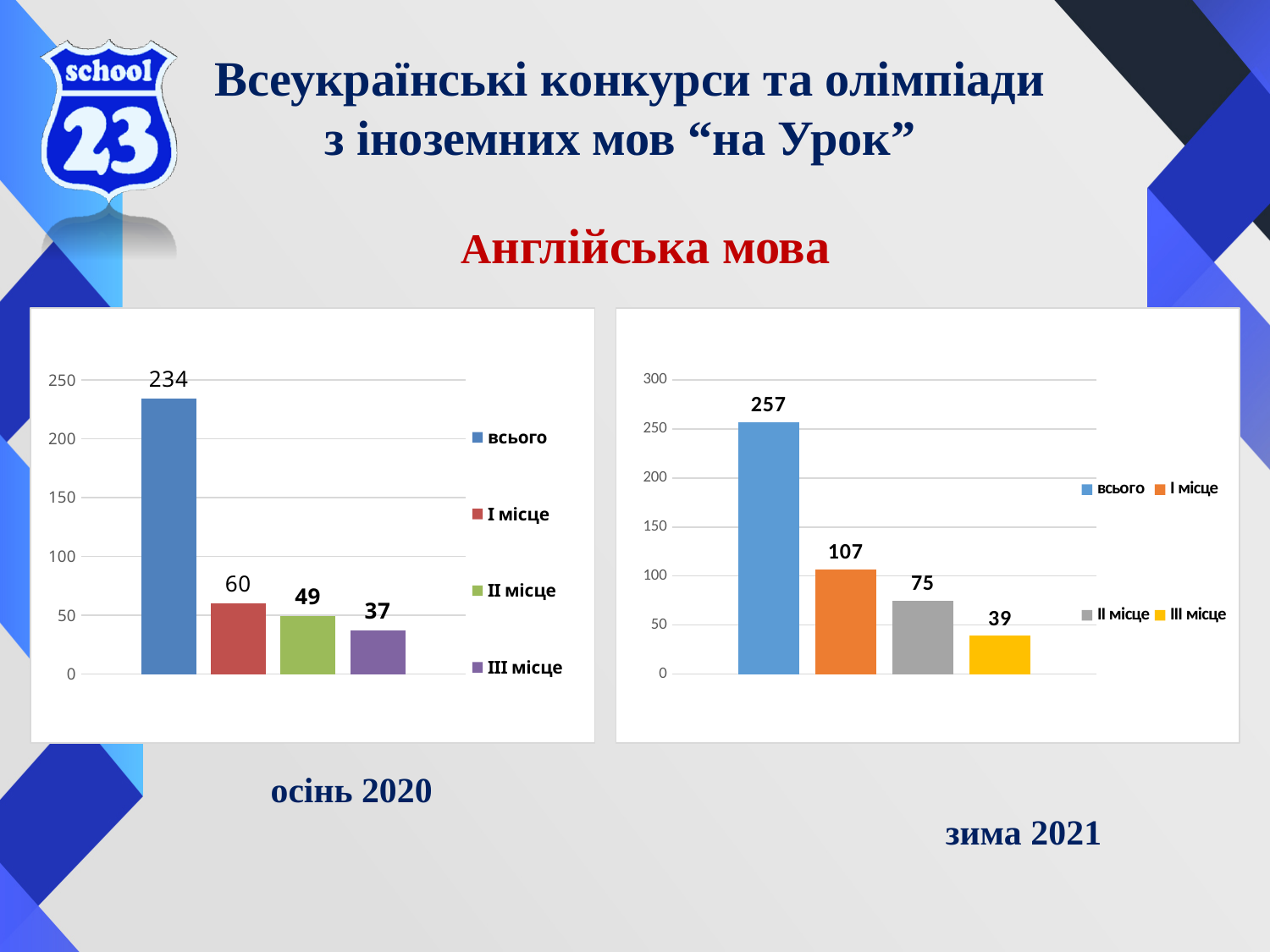
How many series does the legend of the right chart (зима 2021) list? 4 In the right chart (зима 2021), do the values rise or fall from left to right? fall In the right chart (зима 2021), which series has the lowest value? III місце In the left chart (осінь 2020), what is the value for III місце? 37 What kind of chart is the left chart (осінь 2020)? bar chart In the right chart (зима 2021), what is the value for I місце? 107 In the right chart (зима 2021), what colour is the bar for III місце? yellow In the left chart (осінь 2020), what is the value for всього? 234 In the left chart (осінь 2020), what is the difference between I місце and II місце? 11 In the left chart (осінь 2020), which series has the highest value? всього In the right chart (зима 2021), what is the difference between всього and I місце? 150 Which is larger: II місце in the left chart (осінь 2020) or II місце in the right chart (зима 2021)? зима 2021